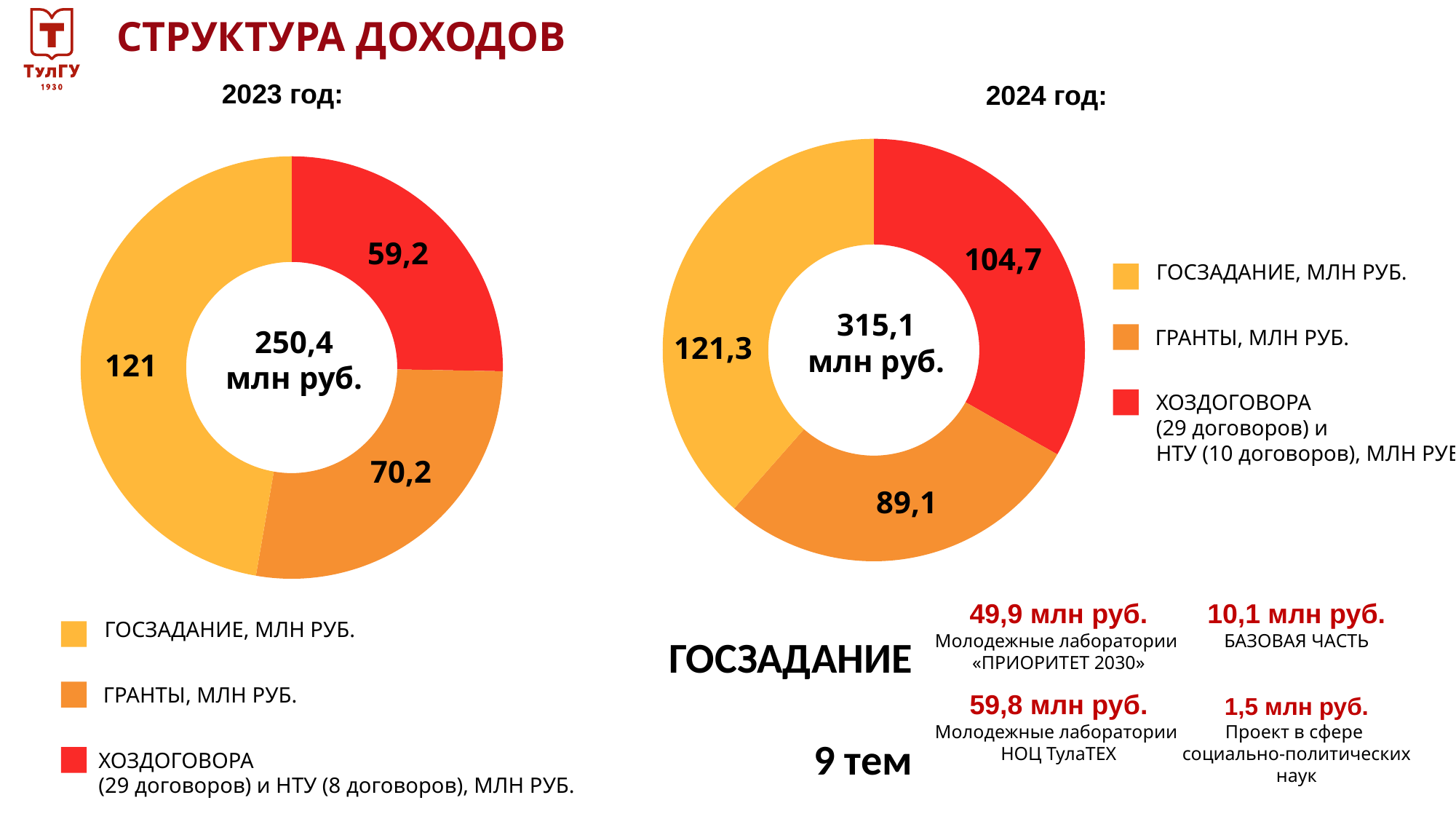
What is the total shown in the centre of the 2024 chart? 315,1 млн руб. In the 2023 chart, what is the value for ГОСЗАДАНИЕ? 121 In the 2023 chart, which category has the lowest value? ХОЗДОГОВОРА In the 2024 chart, what is the value for ХОЗДОГОВОРА? 104,7 In the 2023 chart, what is the difference between ГОСЗАДАНИЕ and ГРАНТЫ? 50,8 What kind of chart is used for the 2023 data? Doughnut (pie) chart In the 2023 chart, which is larger: ГРАНТЫ or ХОЗДОГОВОРА? ГРАНТЫ In the 2024 chart, which category has the highest value? ГОСЗАДАНИЕ In the 2024 chart, what is the difference between ХОЗДОГОВОРА and ГРАНТЫ? 15,6 How many categories does the 2023 chart show? 3 In the 2024 chart, what is the value for ГРАНТЫ? 89,1 In the 2024 chart legend, which colour represents ГРАНТЫ? Orange